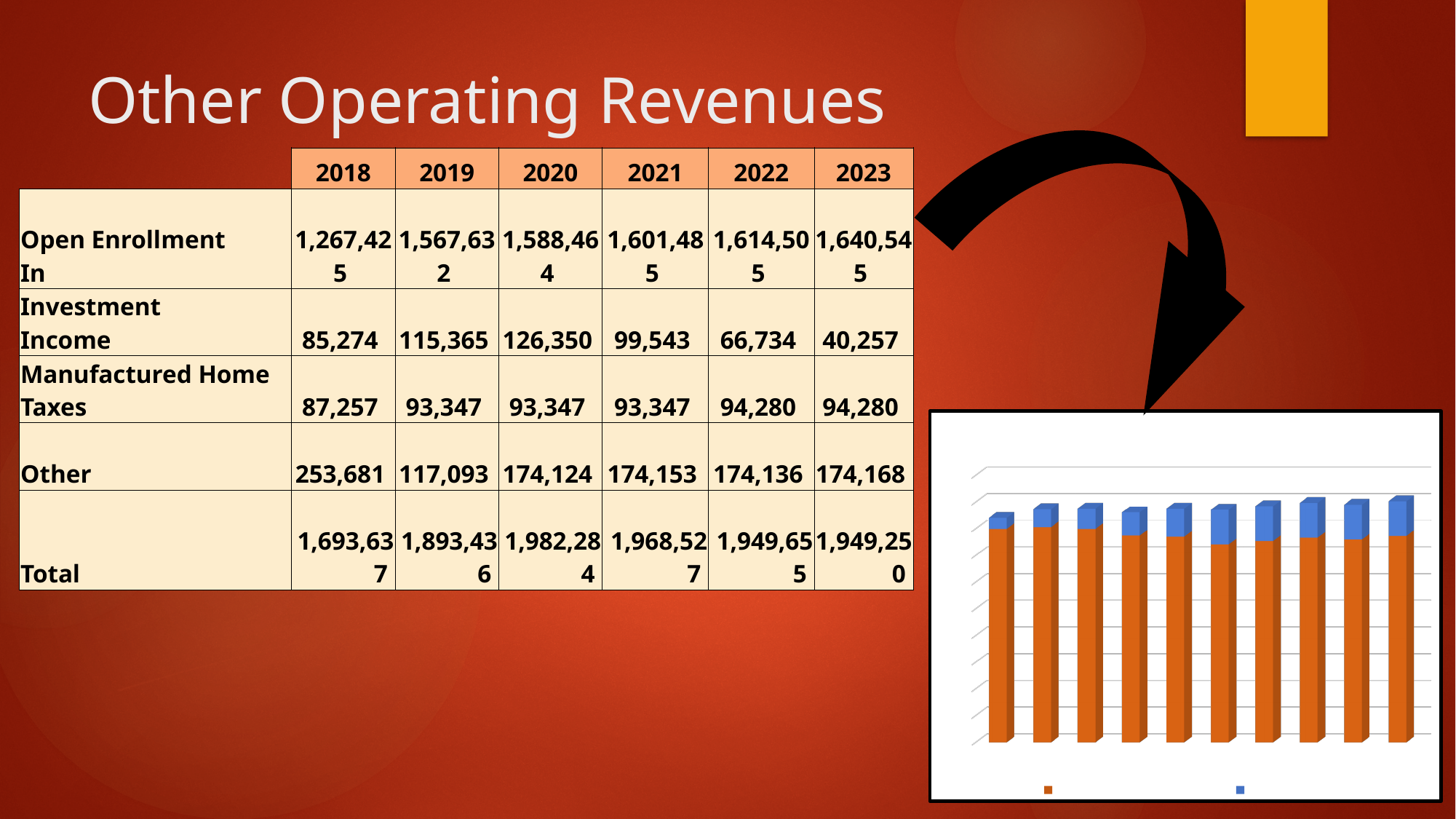
How many series does the chart's legend list? 2 What two colours are used for the segments of the bars in the chart? orange and blue What kind of chart is shown on the slide? bar chart Are the bars in the chart stacked or side by side? stacked How many bars are plotted in the chart? 10 In the chart, which colour segment is larger in each bar, the orange or the blue? orange